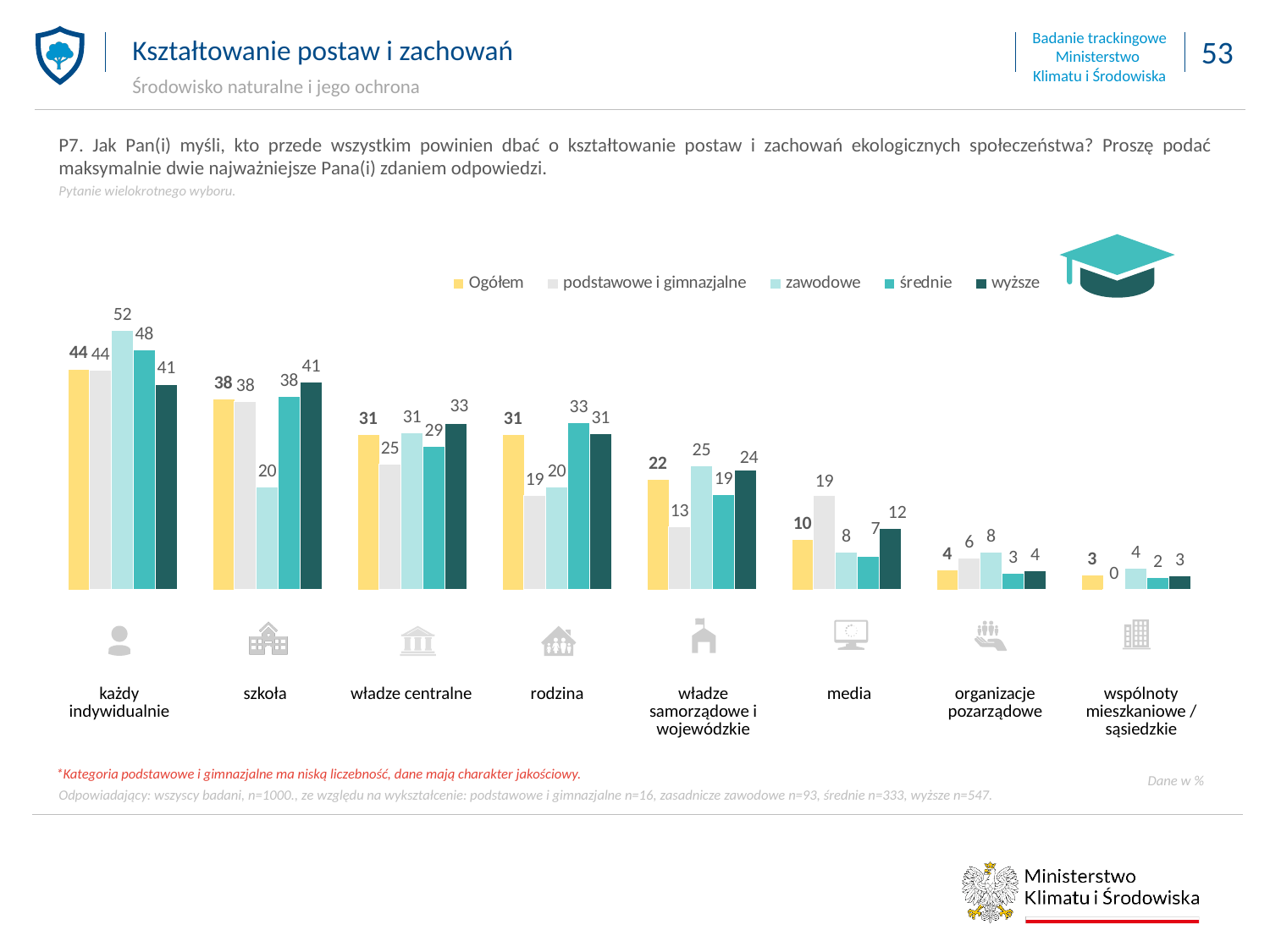
What is the value for 'zawodowe' in the 'szkoła' category? 20 How many series does the legend list? 5 What is the value for 'wyższe' in the 'media' category? 12 What is the value for 'podstawowe i gimnazjalne' in the 'wspólnoty mieszkaniowe / sąsiedzkie' category? 0 Which category has the highest Ogółem value? każdy indywidualnie What is the difference between the 'zawodowe' and 'wyższe' values for 'każdy indywidualnie'? 11 Which is larger for 'rodzina': the 'średnie' value or the 'podstawowe i gimnazjalne' value? średnie Which category has the lowest Ogółem value? wspólnoty mieszkaniowe / sąsiedzkie What kind of chart is shown on the slide? bar chart What is the Ogółem value for 'każdy indywidualnie'? 44 How many categories are shown on the x axis? 8 Do the Ogółem values rise or fall from left to right across the categories? fall